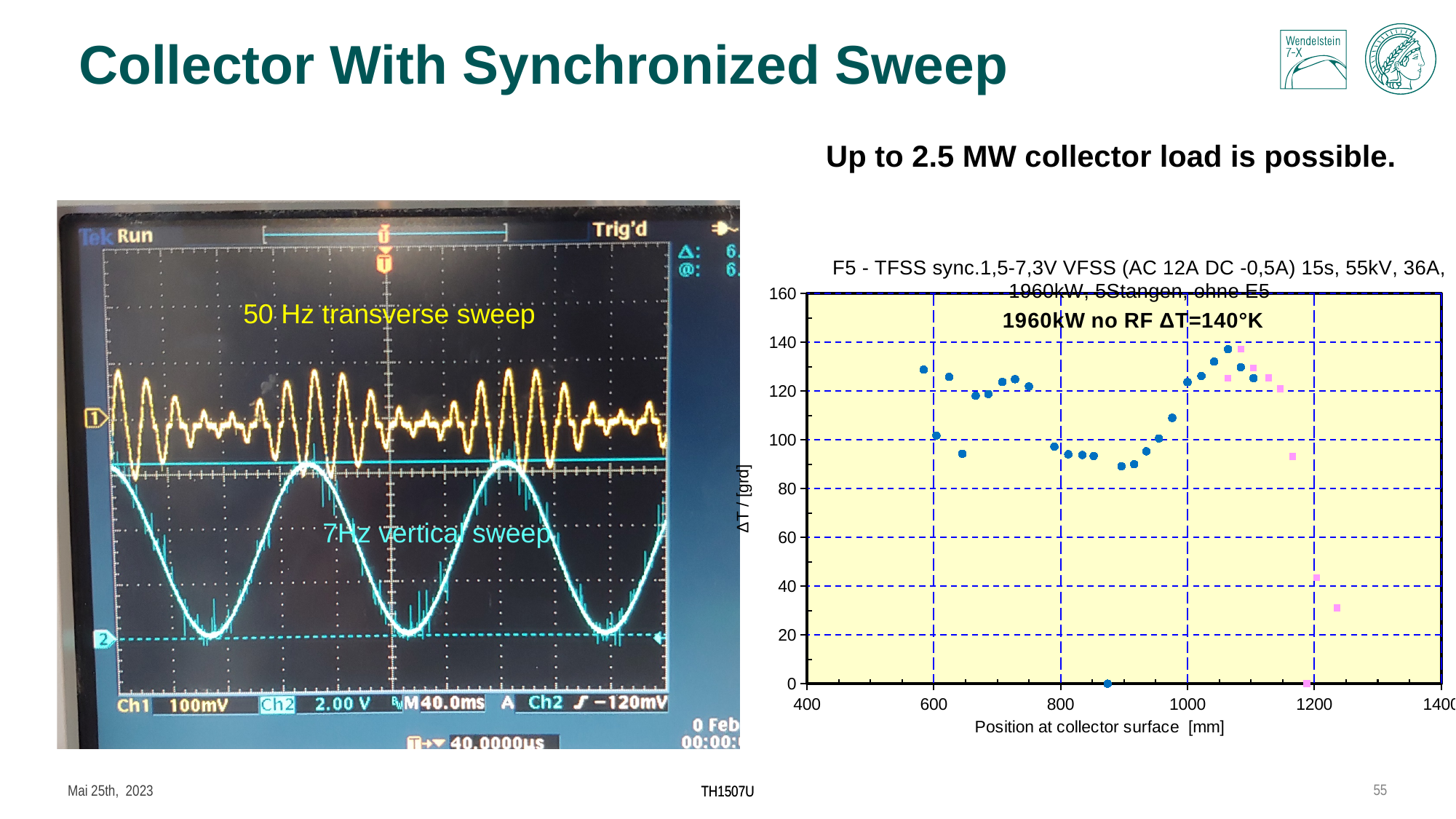
In the scatter chart on the right, what ΔT value is stated in the bold annotation '1960kW no RF'? ΔT=140°K In the scatter chart on the right, what is the label of the x axis? Position at collector surface [mm] In the scatter chart on the right, do the blue values rise or fall as the position increases from 900 mm to 1060 mm? rise In the scatter chart on the right, is the pink point near 1240 mm greater or less than 40? less What kind of chart is shown on the right side of the slide? scatter chart In the scatter chart on the right, is the pink point near 1200 mm greater or less than 60? less In the scatter chart on the right, is the highest blue point (near 1060 mm) greater or less than 120? greater In the scatter chart on the right, do the pink values rise or fall as the position increases from 1100 mm to 1240 mm? fall In the scatter chart on the right, which is larger: the blue value near 1060 mm or the blue value near 850 mm? the blue value near 1060 mm In the scatter chart on the right, what is the maximum value shown on the y axis? 160